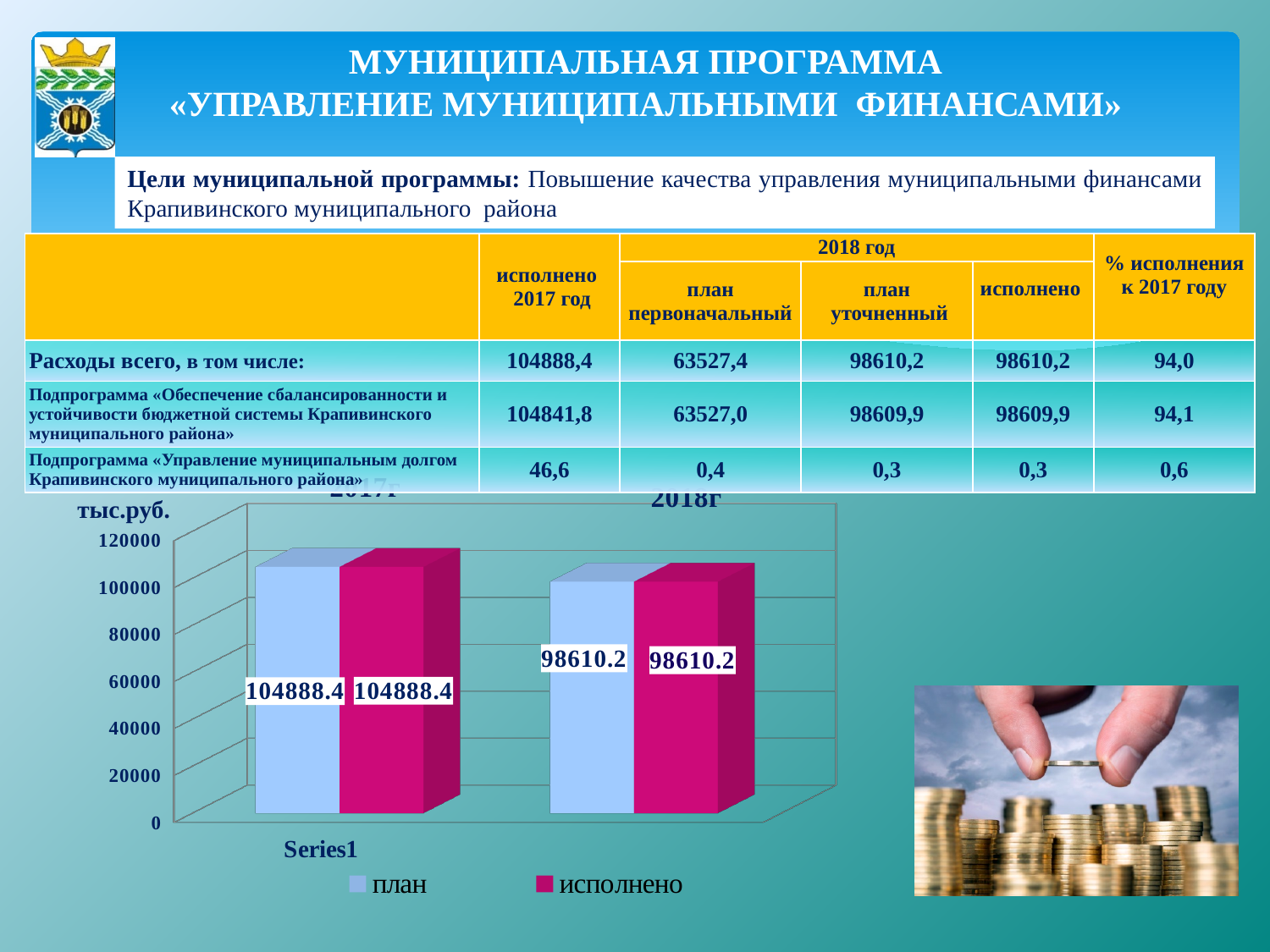
What is the value of the 'исполнено' bar in the 2018г group? 98610.2 Is the 'исполнено' value in the 2018г group greater or less than 100000? less What is the difference between the 'план' value in the left (2017) group and the 'план' value in the 2018г group? 6278.2 How many series does the chart legend list? 2 Is the 'план' value in the left (2017) group greater or less than 100000? greater What unit is written above the vertical axis of the chart? тыс.руб. What kind of chart is shown on the slide? bar chart What is the value of the 'исполнено' bar in the left (2017) group? 104888.4 What is the value of the 'план' bar in the 2018г group? 98610.2 Which group has the larger 'исполнено' value, the left (2017) group or the 2018г group? the left (2017) group What are the two series named in the chart legend? план, исполнено How many bars are plotted in the chart in total? 4